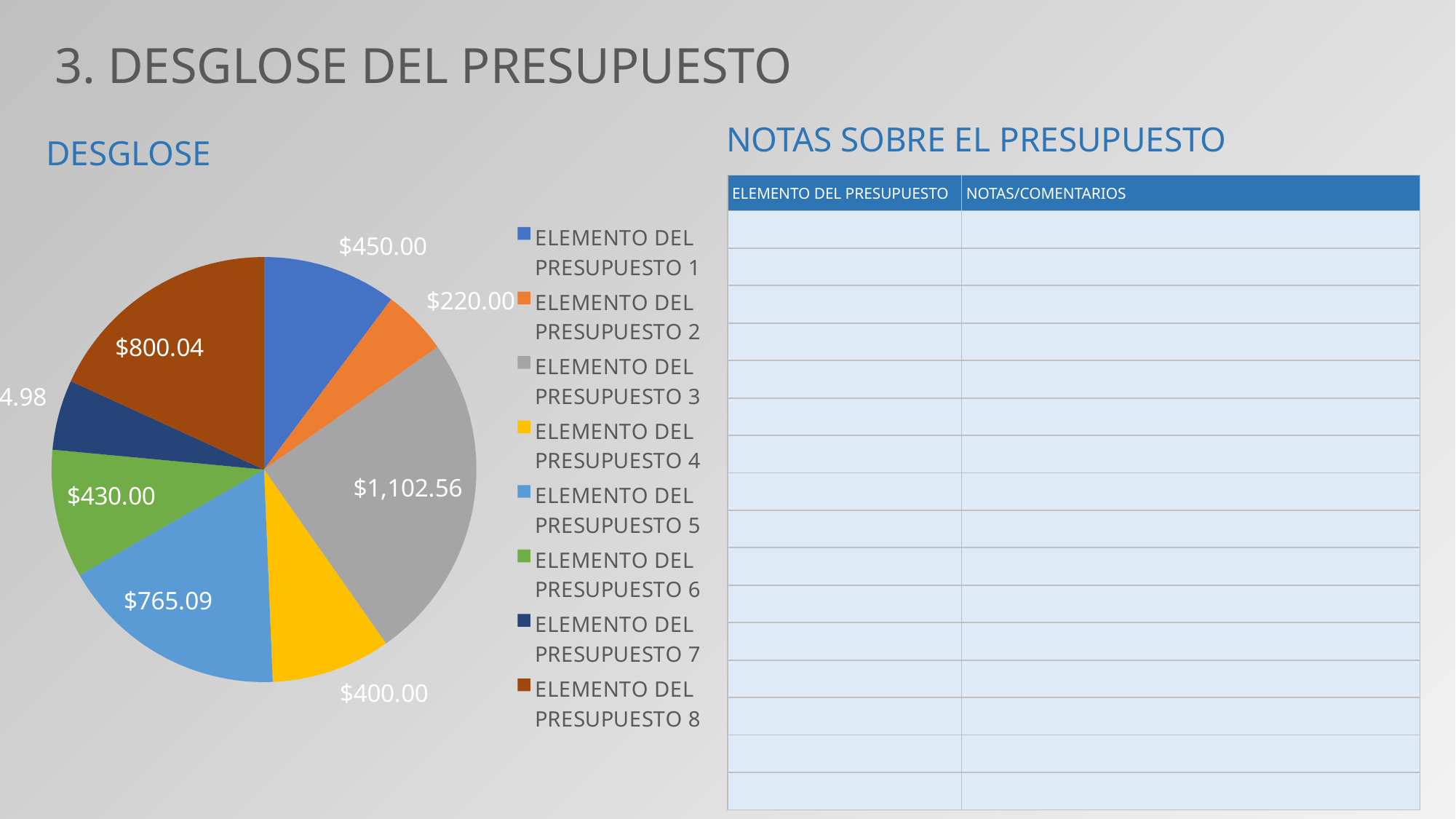
What is the difference between the values for ELEMENTO DEL PRESUPUESTO 6 and ELEMENTO DEL PRESUPUESTO 4? $30.00 What is the value shown for ELEMENTO DEL PRESUPUESTO 2 in the pie chart? $220.00 Which is larger, the value for ELEMENTO DEL PRESUPUESTO 8 or ELEMENTO DEL PRESUPUESTO 5? ELEMENTO DEL PRESUPUESTO 8 How many budget elements are listed in the pie chart legend? 8 What is the difference between the values for ELEMENTO DEL PRESUPUESTO 3 and ELEMENTO DEL PRESUPUESTO 1? $652.56 Which budget element has the largest slice in the pie chart? ELEMENTO DEL PRESUPUESTO 3 What kind of chart is shown under the heading DESGLOSE? Pie chart What is the value shown for ELEMENTO DEL PRESUPUESTO 1 in the pie chart? $450.00 What is the value shown for ELEMENTO DEL PRESUPUESTO 3 in the pie chart? $1,102.56 What colour is the slice for ELEMENTO DEL PRESUPUESTO 3 in the pie chart? Gray What is the value shown for ELEMENTO DEL PRESUPUESTO 5 in the pie chart? $765.09 What is the value shown for ELEMENTO DEL PRESUPUESTO 8 in the pie chart? $800.04